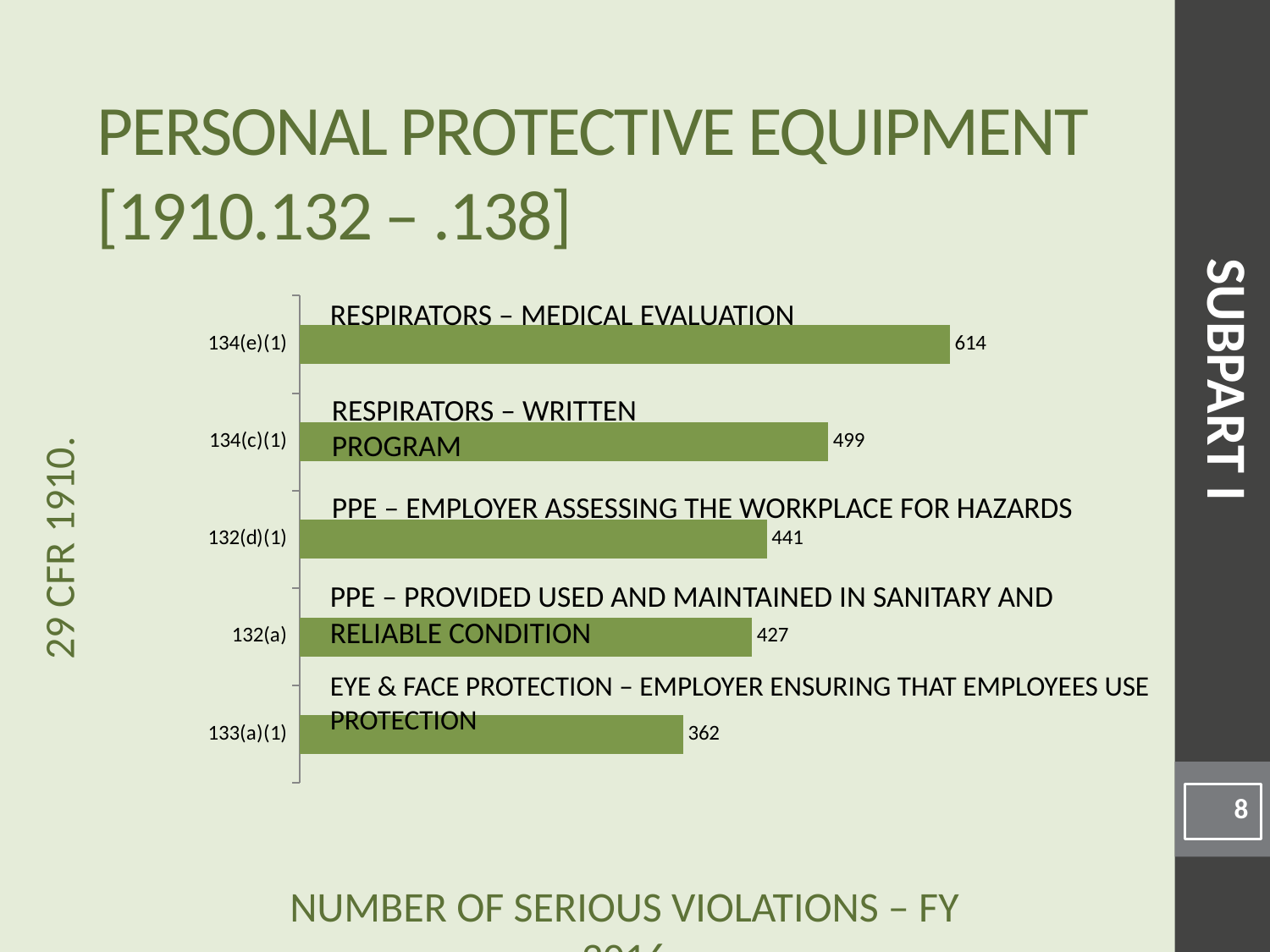
What is the number of serious violations for 134(c)(1)? 499 What is the difference between the values for 132(d)(1) and 133(a)(1)? 79 What is the number of serious violations for 132(a)? 427 What is the number of serious violations for 134(e)(1)? 614 What is the difference between the values for 134(e)(1) and 134(c)(1)? 115 Which has more serious violations, 132(d)(1) or 132(a)? 132(d)(1) What kind of chart is shown on the slide? Bar chart How many categories are shown in the chart? 5 Which category has the highest number of serious violations? 134(e)(1) Which category has the lowest number of serious violations? 133(a)(1) What is the number of serious violations for 133(a)(1)? 362 What is the number of serious violations for 132(d)(1)? 441